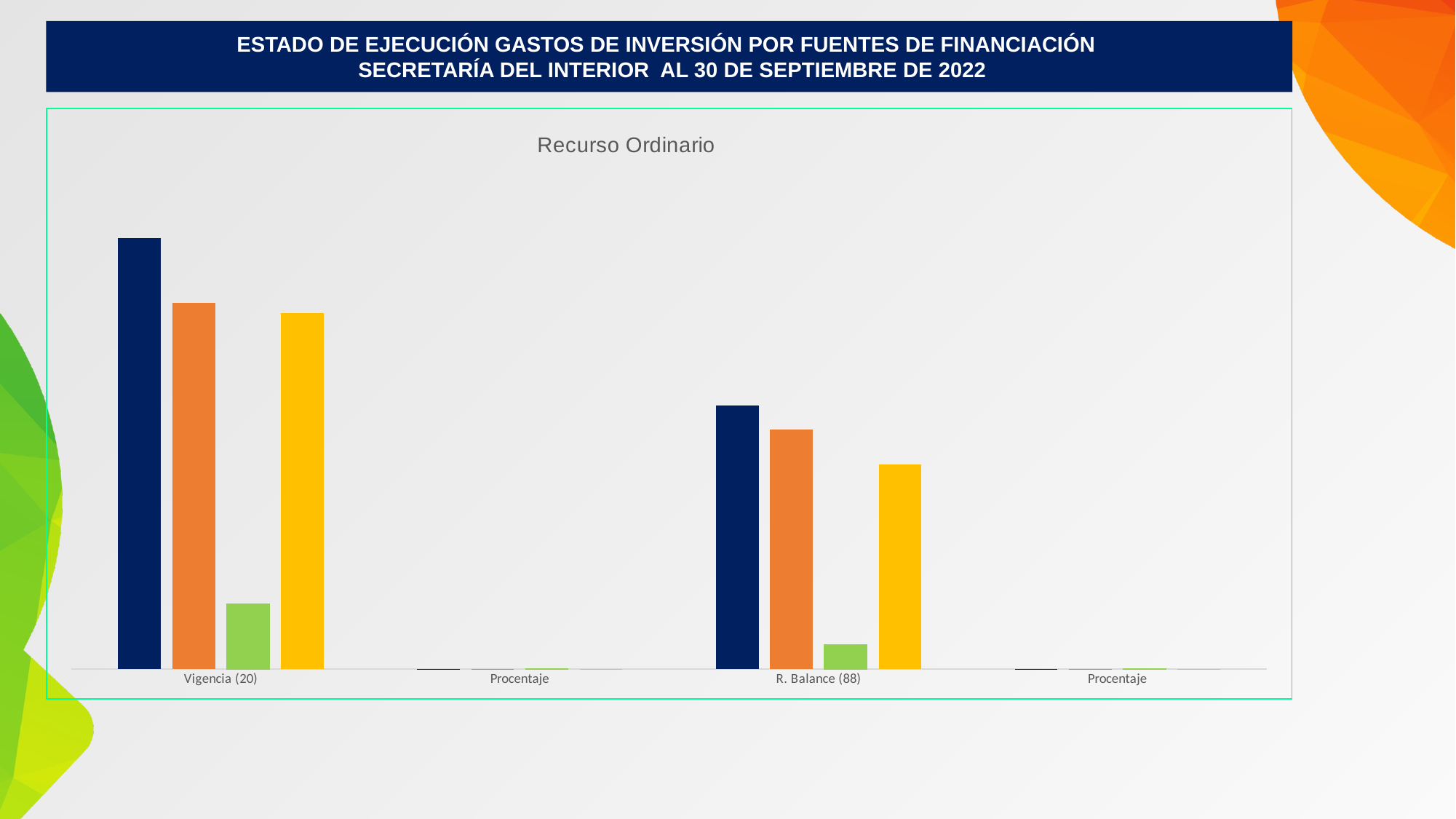
Which category has the tallest bar in the chart? Vigencia (20) Which is larger, the dark blue bar for Vigencia (20) or the dark blue bar for R. Balance (88)? Vigencia (20) Which is larger, the yellow bar for Vigencia (20) or the yellow bar for R. Balance (88)? Vigencia (20) What is the title of the chart? Recurso Ordinario Within the category R. Balance (88), which coloured bar is the tallest? The dark blue bar How many categories are shown on the x axis of the chart? 4 What is the label of the first category on the x axis? Vigencia (20) How many bars are plotted for the category Vigencia (20)? 4 Which is larger, the orange bar for R. Balance (88) or the green bar for R. Balance (88)? The orange bar Within the category Vigencia (20), which coloured bar is the shortest? The green bar What kind of chart is shown on the slide? Bar chart